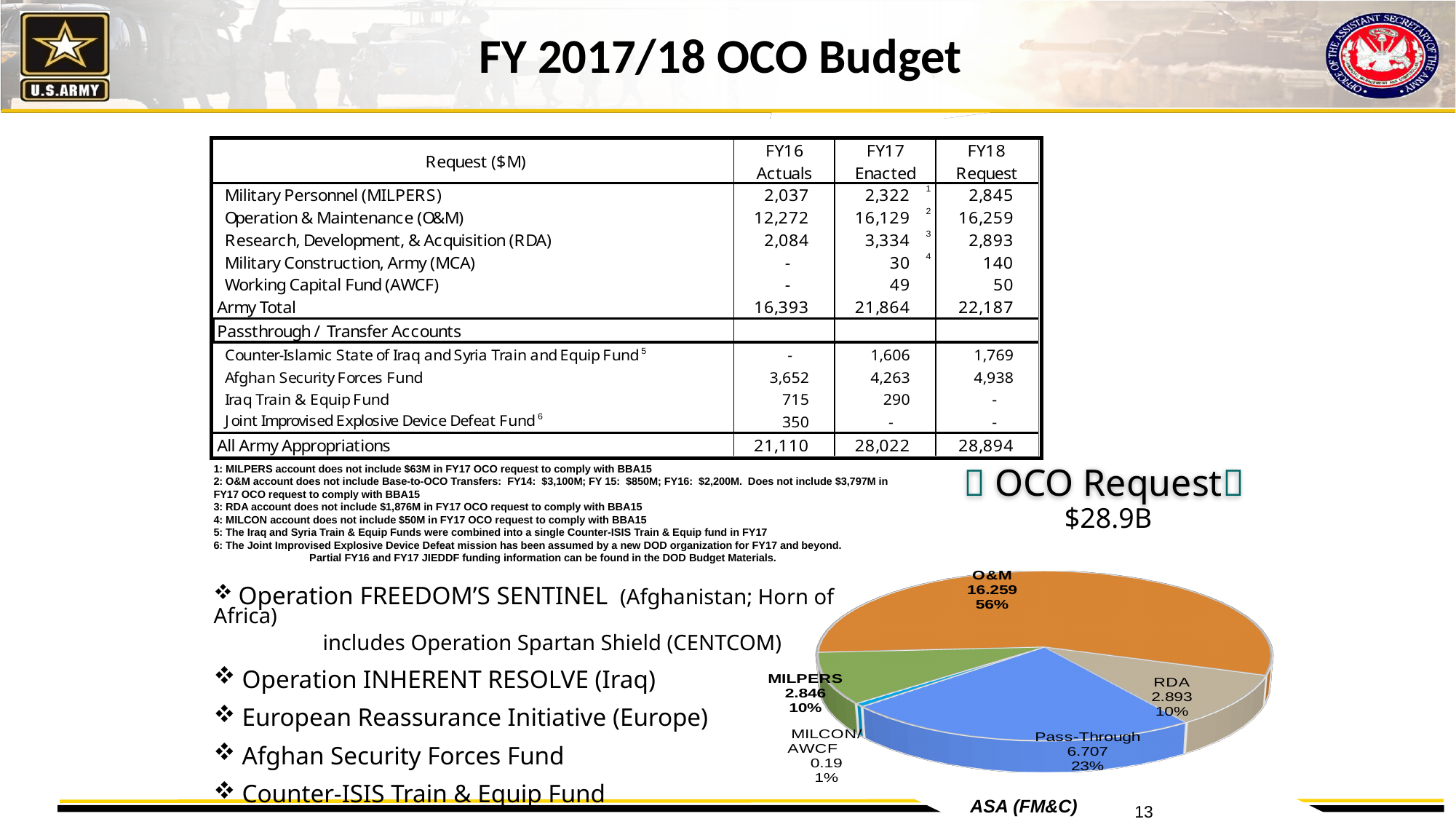
Which is larger in the pie chart, Pass-Through or RDA? Pass-Through What total OCO Request amount is shown above the pie chart? $28.9B Which slice of the pie chart is the largest? O&M What value is shown for the Pass-Through slice of the pie chart? 6.707 What kind of chart is shown on the slide? pie chart What value is shown for the O&M slice of the pie chart? 16.259 What share of the pie does Pass-Through represent? 23% Which slice of the pie chart is the smallest? MILCON/AWCF What value is shown for the MILCON/AWCF slice of the pie chart? 0.19 What value is shown for the MILPERS slice of the pie chart? 2.846 What share of the pie does O&M represent? 56% How many slices does the pie chart have? 5